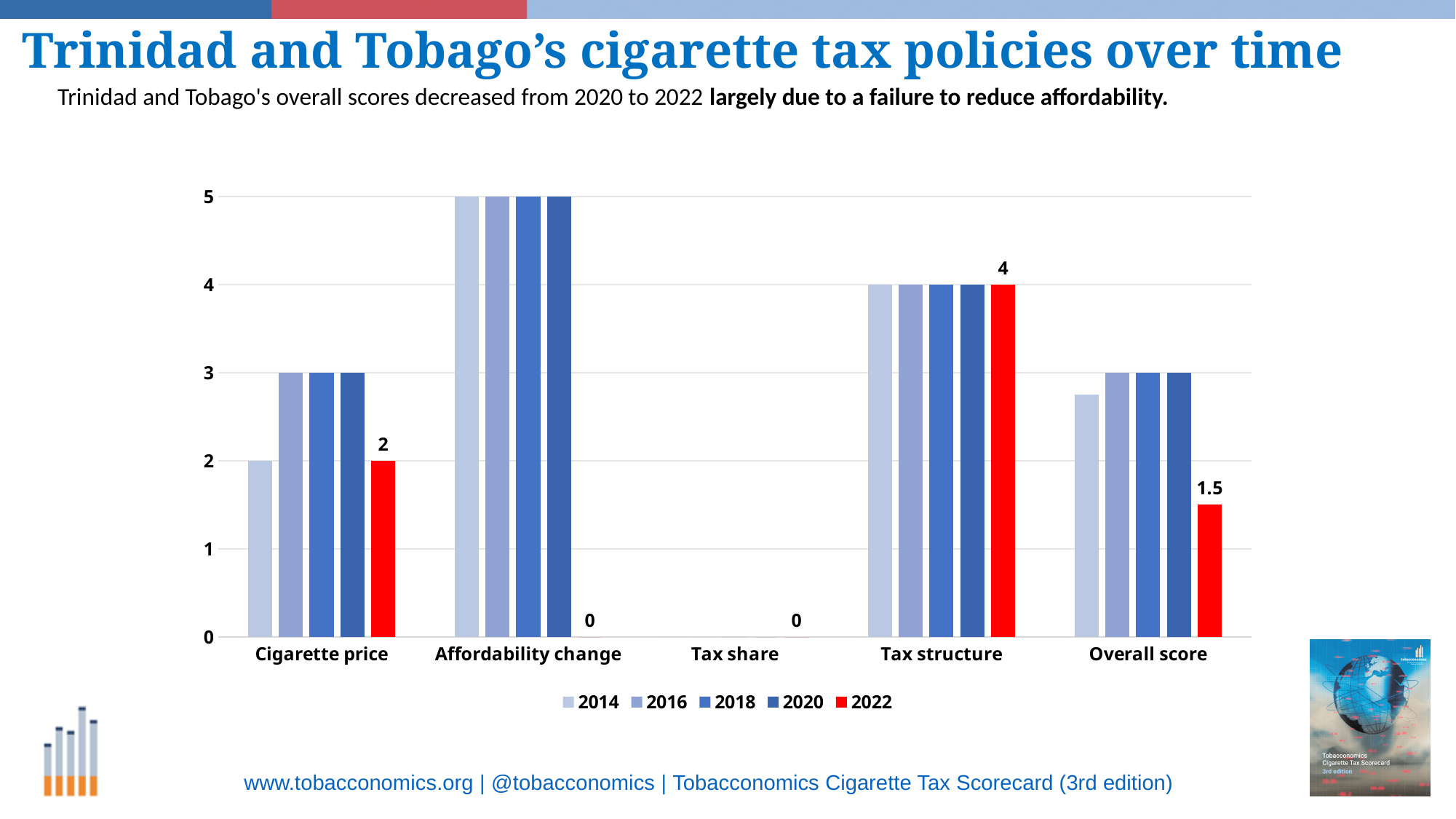
What is the 2020 value for Affordability change? 5 What is the 2022 value for Cigarette price? 2 What kind of chart is shown on the slide? bar chart What is the difference between the 2022 values for Tax structure and Overall score? 2.5 How many categories are shown on the x axis? 5 What is the 2022 value for Overall score? 1.5 Is the 2014 value for Overall score greater or less than 3? less Which category has the highest 2022 value? Tax structure Which series is shown in red? 2022 What is the 2022 value for Affordability change? 0 What is the 2022 value for Tax structure? 4 How many series does the legend list? 5